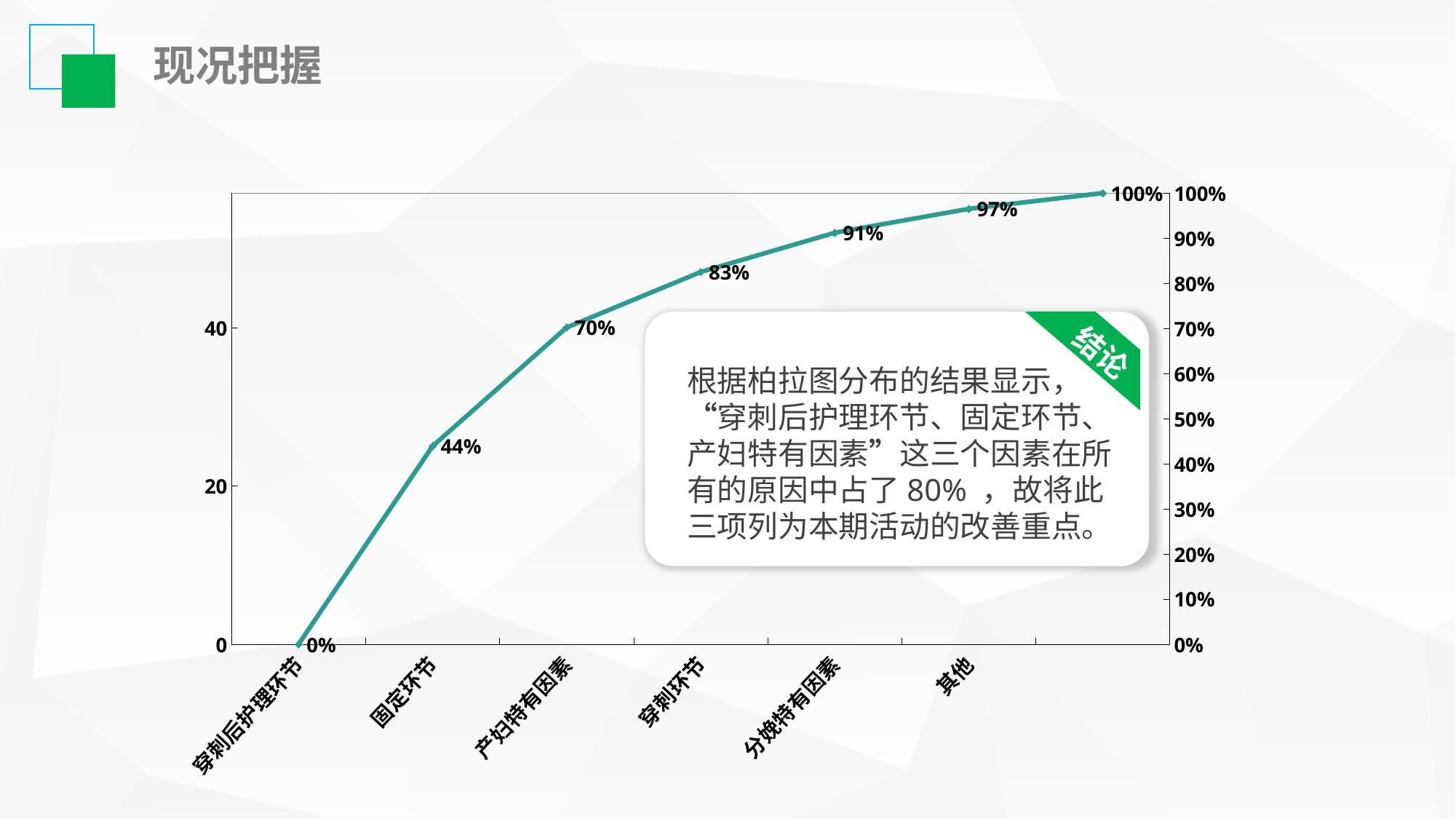
What is the lowest value labelled on the line? 0% What is the difference between the third point (70%) and the second point (44%) on the line? 26% How many category labels are shown along the x axis of the chart? 6 What is the value labelled on the third point from the left of the line? 70% Which is larger, the value labelled 91% or the value labelled 97%? 97% What kind of chart is shown on the slide? line chart What is the value labelled on the fourth point from the left of the line? 83% What is the highest value labelled on the line? 100% How many data points are labelled on the line in the chart? 7 What is the highest tick value shown on the right-hand vertical axis? 100% What is the value labelled on the second point from the left of the line? 44% Do the values on the line rise or fall from left to right? rise